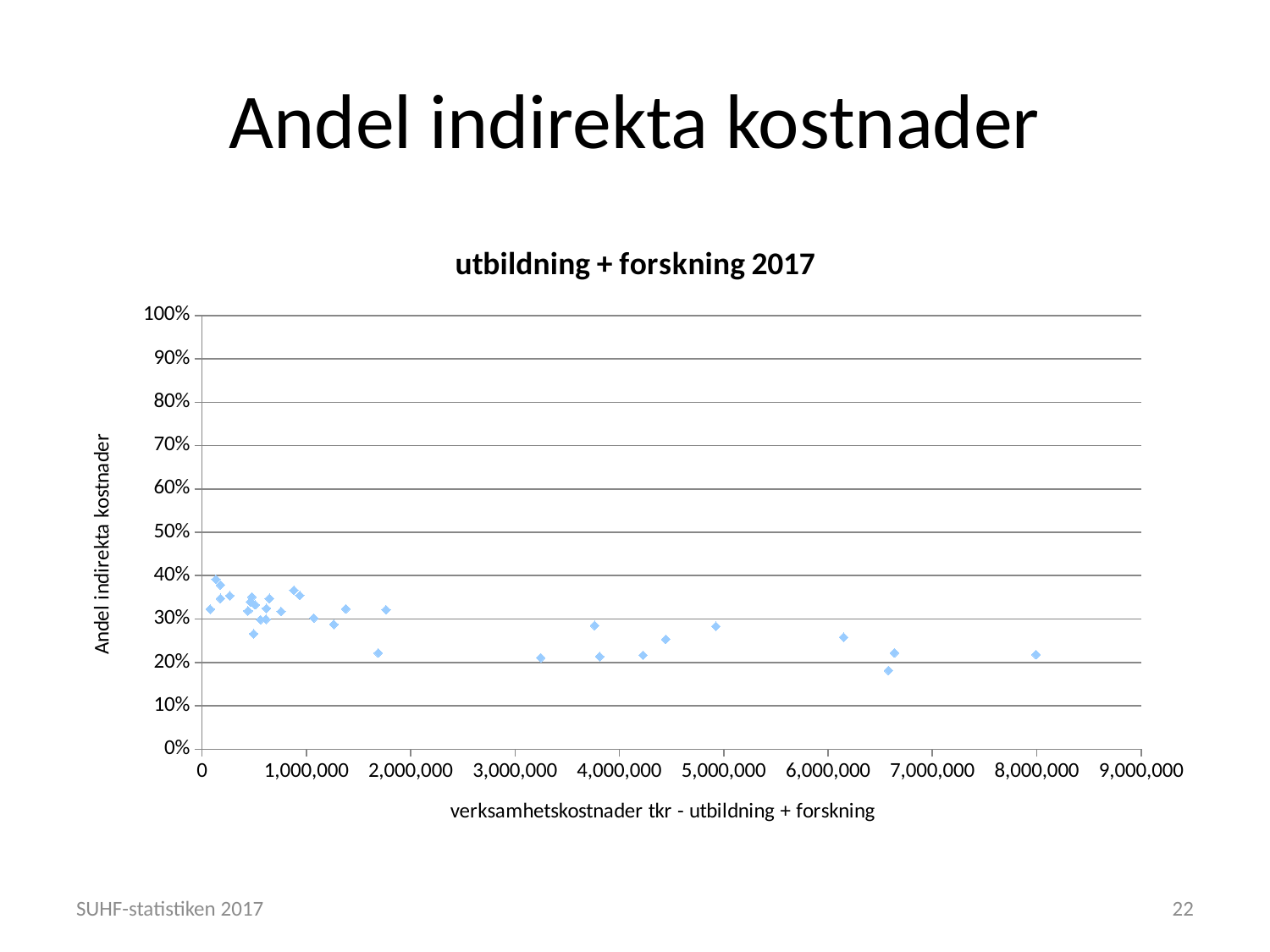
What kind of chart is shown on the slide? scatter chart As verksamhetskostnader increases along the x axis, do the plotted shares of indirect costs generally rise or fall? fall Is the value for the point plotted near 3,200,000 on the x axis greater or less than 30%? less What is the label of the x axis of the chart? verksamhetskostnader tkr - utbildning + forskning Are any of the plotted points above 50% on the y axis? No Is the value for the point plotted near 4,900,000 on the x axis greater or less than 20%? greater What is the title of the chart? utbildning + forskning 2017 Are the points with the highest shares of indirect costs found at the low or the high end of the x axis? low end